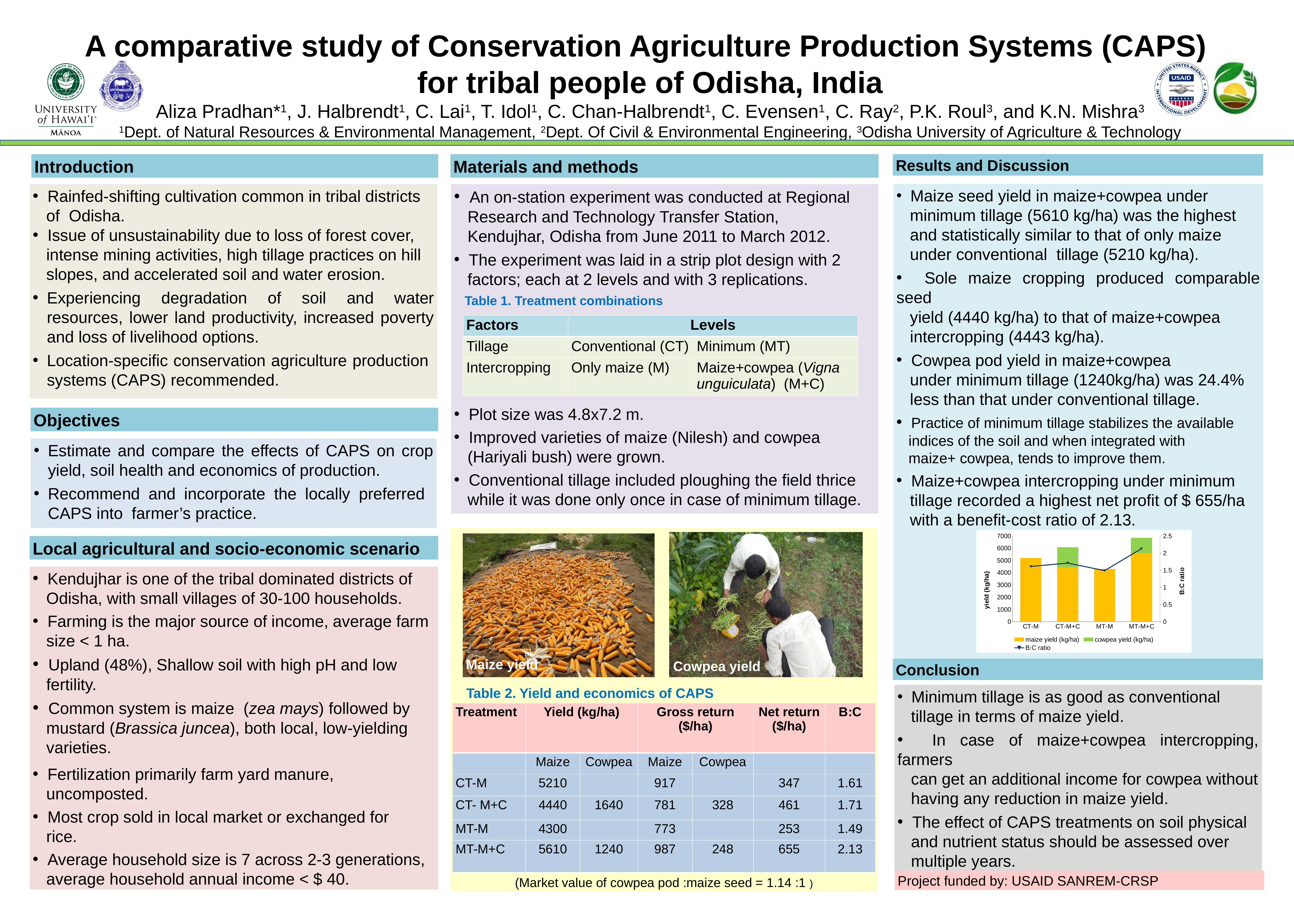
What is the label of the left vertical axis of the chart? yield (kg/ha) What kind of chart is the yield and B:C ratio chart? Bar chart with a line Is the maize yield bar larger for CT-M or for MT-M? CT-M Is the B:C ratio point for MT-M+C greater or less than 2? greater Which treatment has the highest B:C ratio on the line in the chart? MT-M+C Which treatment has the shortest stacked bar in the yield chart? MT-M How many categories are shown on the x axis of the yield chart? 4 Is the maize yield bar for MT-M greater or less than 5000 kg/ha? less Is the maize yield bar for CT-M greater or less than 5000 kg/ha? greater Which treatment has the tallest stacked bar in the yield chart? MT-M+C Is the cowpea yield segment larger for CT-M+C or for MT-M+C? CT-M+C How many series does the legend of the yield chart list? 3